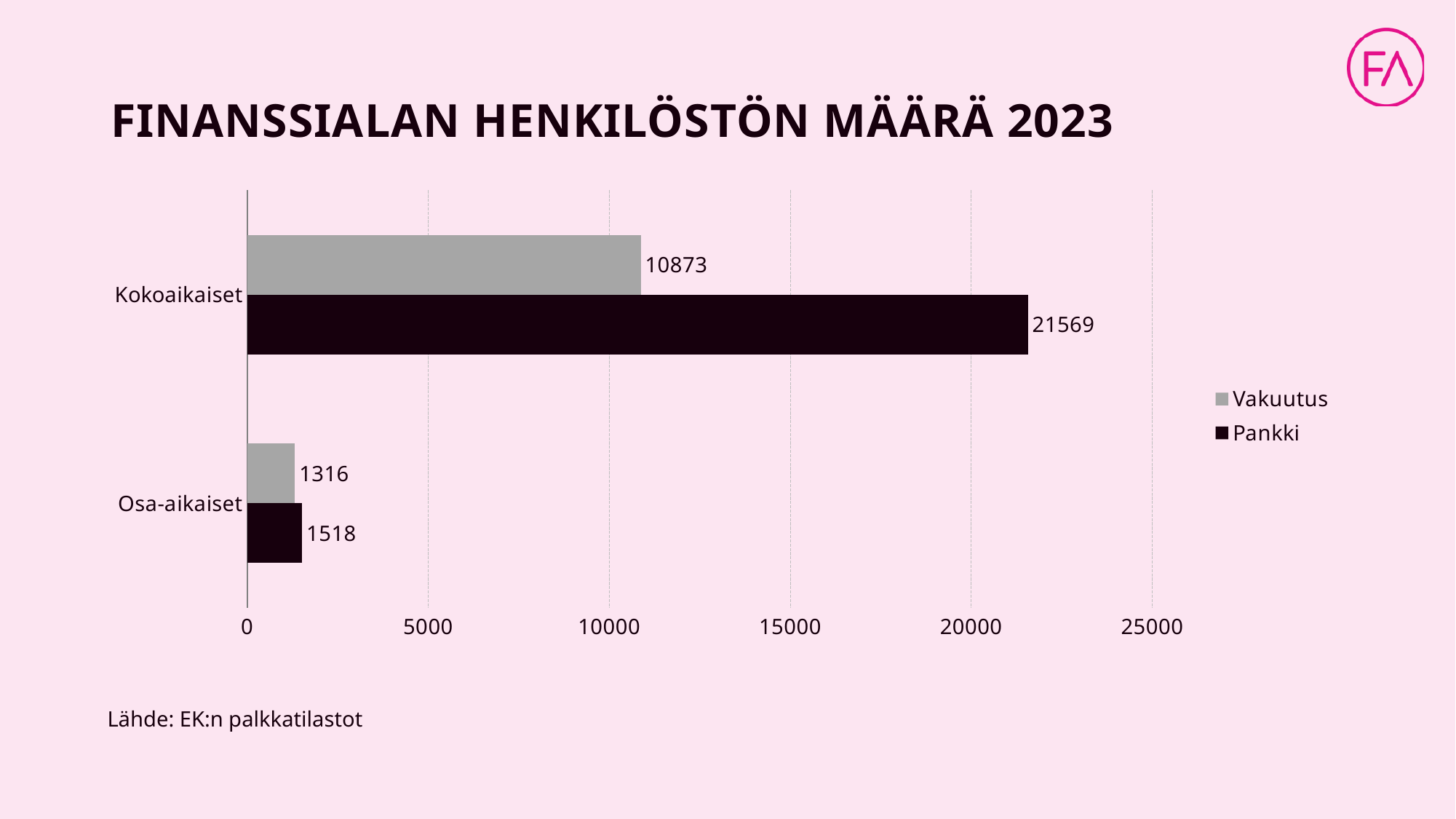
What is the value for Pankki in the Kokoaikaiset category? 21569 How many categories are shown on the y axis? 2 What is the value for Vakuutus in the Kokoaikaiset category? 10873 What is the difference between the Pankki and Vakuutus values for Osa-aikaiset? 202 What is the difference between the Pankki and Vakuutus values for Kokoaikaiset? 10696 Which bar has the lowest value on the chart? Vakuutus, Osa-aikaiset What is the value for Vakuutus in the Osa-aikaiset category? 1316 Which is larger for Kokoaikaiset: Vakuutus or Pankki? Pankki What kind of chart is shown on the slide? Bar chart How many series does the legend list? 2 Which bar has the highest value on the chart? Pankki, Kokoaikaiset What is the value for Pankki in the Osa-aikaiset category? 1518